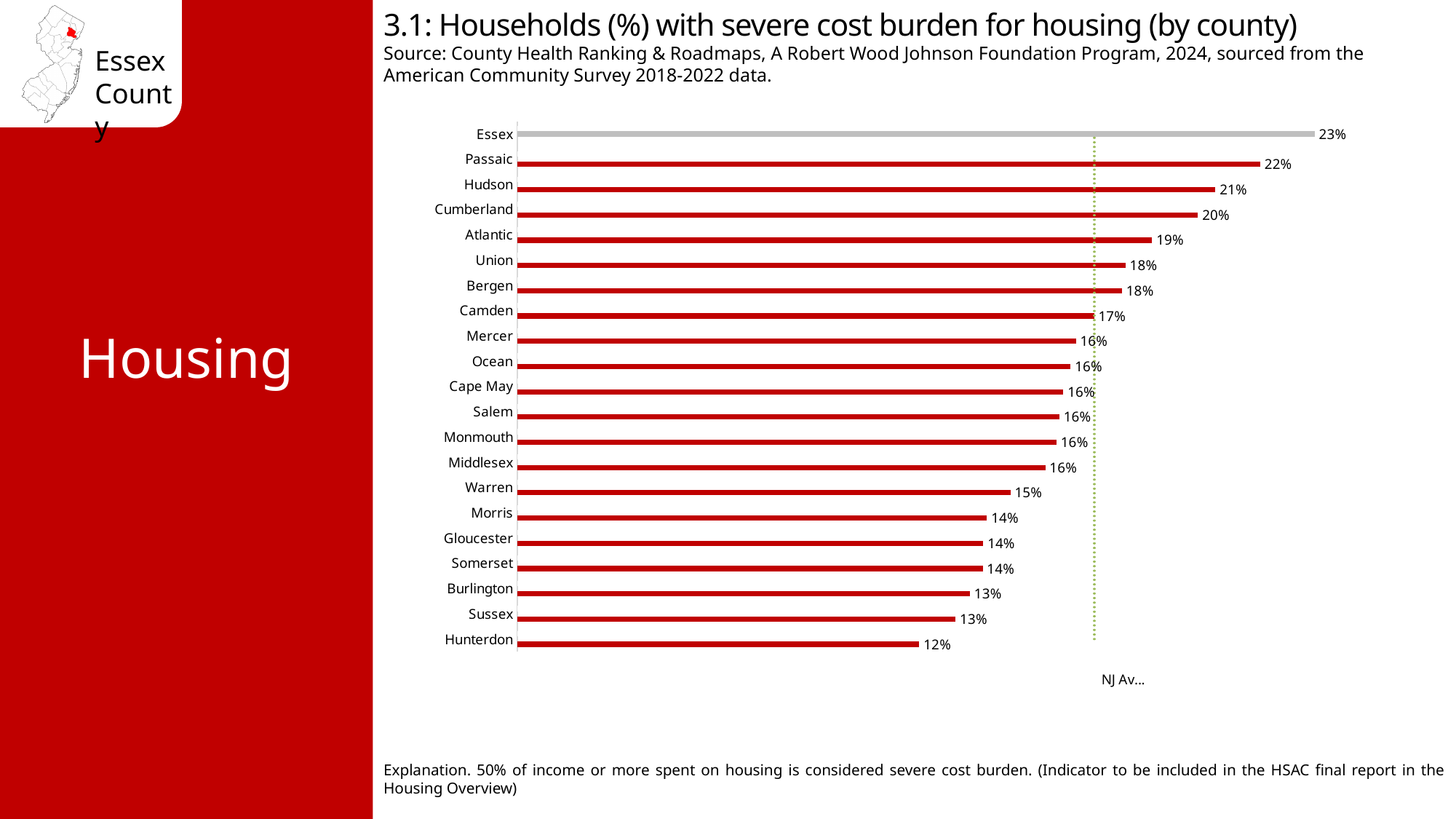
What is the value for Camden? 17% What is the value for Warren? 15% What kind of chart is this? Bar chart What is the value for Hunterdon? 12% Which county has the lowest value? Hunterdon Which is larger, the value for Hudson or the value for Morris? Hudson What is the difference between the values for Essex and Hunterdon? 11% Which county's bar is shown in a different colour (grey) from the others? Essex Which county has the highest value? Essex What is the value for Essex? 23% What is the difference between the values for Passaic and Atlantic? 3% How many counties are shown in the chart? 21